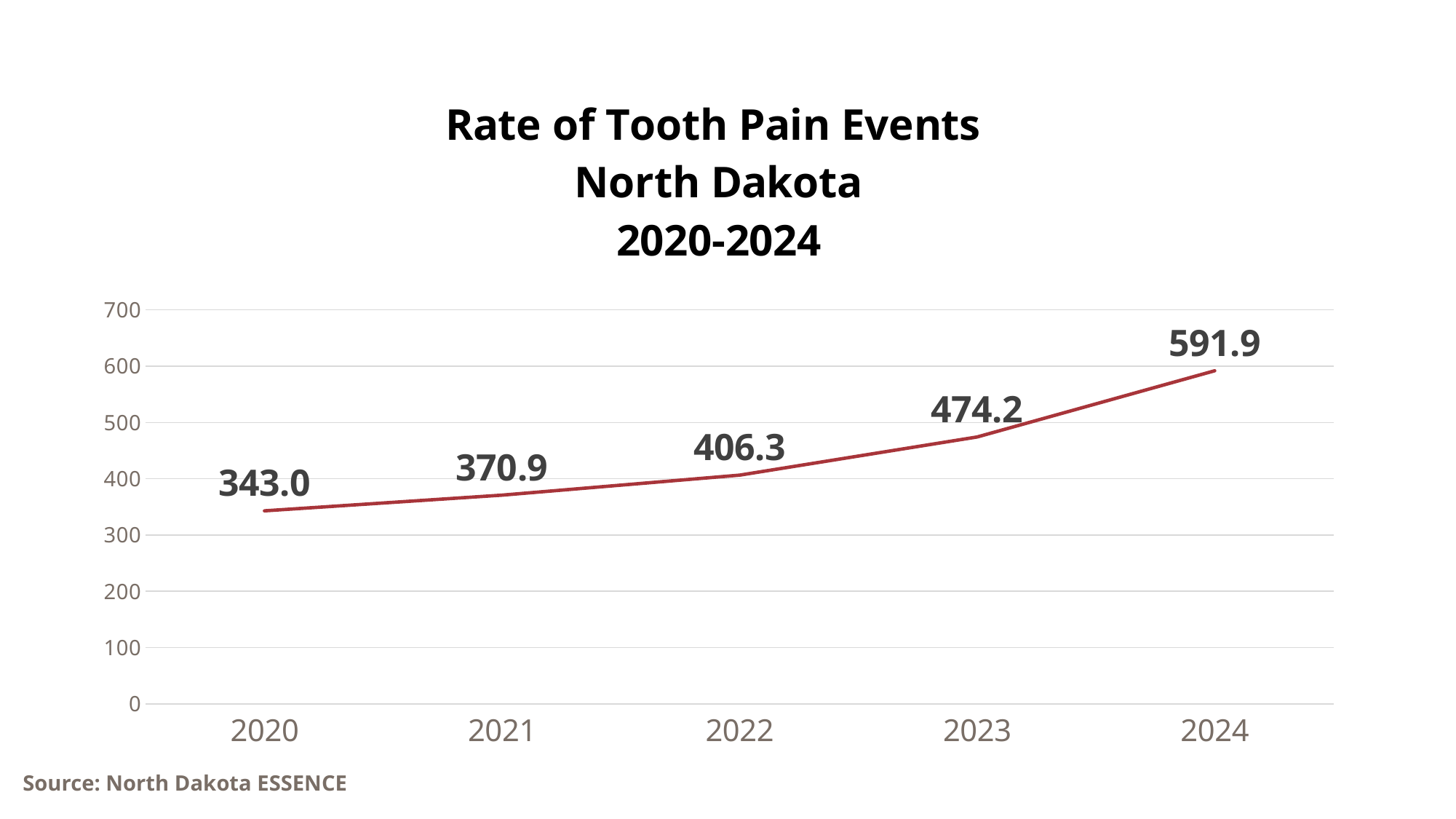
What kind of chart is shown on the slide? Line chart What is the difference between the rate in 2024 and the rate in 2023? 117.7 What is the rate of tooth pain events in 2020? 343.0 What is the difference between the rate in 2021 and the rate in 2020? 27.9 Which year has a higher rate of tooth pain events, 2021 or 2023? 2023 What is the rate of tooth pain events in 2024? 591.9 Do the values rise or fall from 2020 to 2024? Rise Is the value for 2023 greater or less than 500? less Which year has the lowest rate of tooth pain events? 2020 What is the rate of tooth pain events in 2022? 406.3 How many years are plotted on the chart? 5 Which year has the highest rate of tooth pain events? 2024